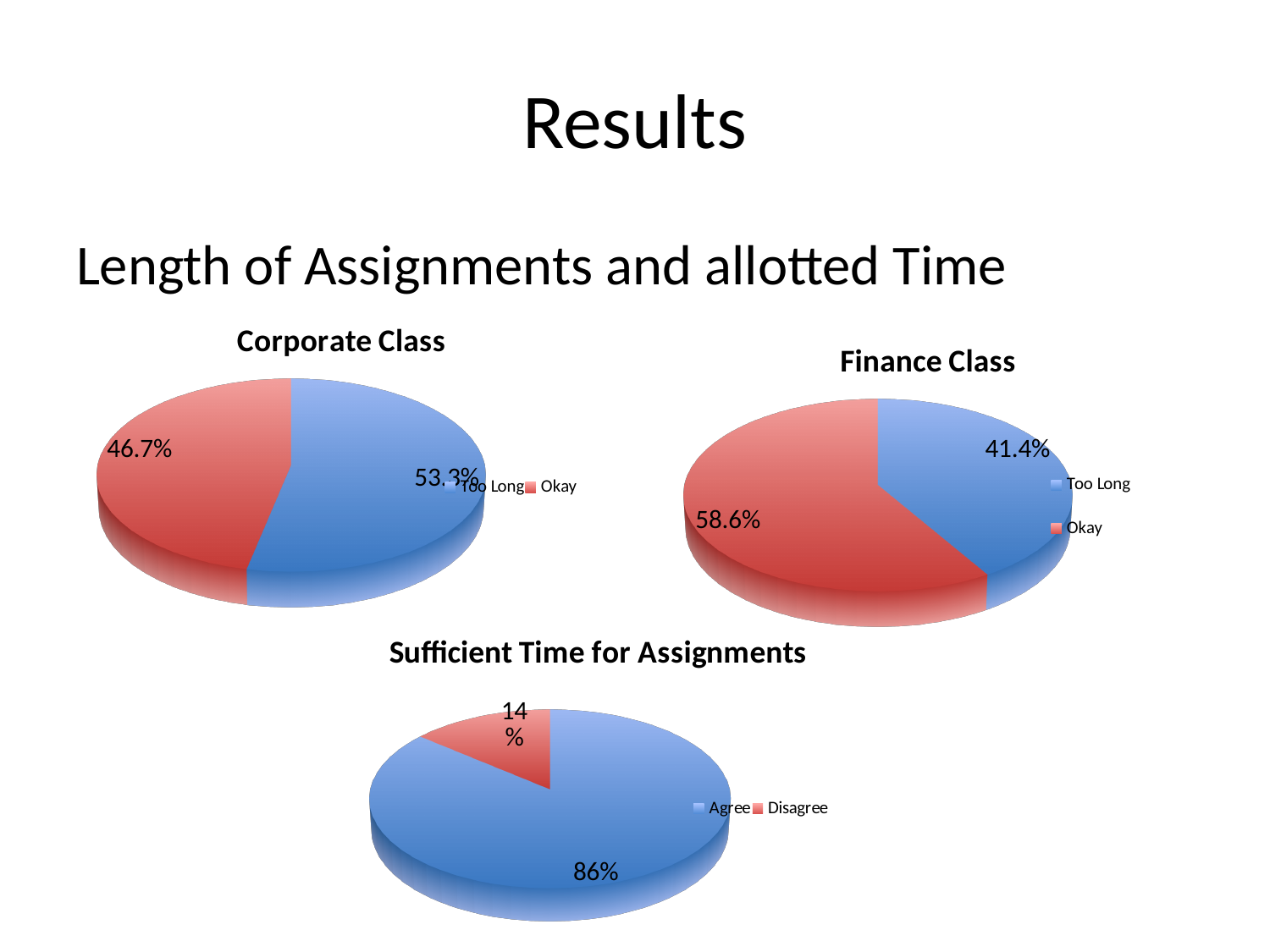
In the Finance Class chart, which category has the largest slice? Okay In the Finance Class chart, what share of responses is labelled Okay? 58.6% In the Finance Class chart, what share of responses is labelled Too Long? 41.4% In the Sufficient Time for Assignments chart, what is the difference between the Agree and Disagree shares? 72% In the Sufficient Time for Assignments chart, what share of responses is Disagree? 14% What type of chart is the Corporate Class chart? Pie chart In the Finance Class chart, what is the difference between the Okay and Too Long shares? 17.2% In the Corporate Class chart, what share of responses is labelled Too Long? 53.3% How many categories does the legend of the Sufficient Time for Assignments chart list? 2 In the Corporate Class chart, what share of responses is labelled Okay? 46.7% In the Corporate Class chart, which category has the smaller slice? Okay In the Sufficient Time for Assignments chart, what share of responses is Agree? 86%